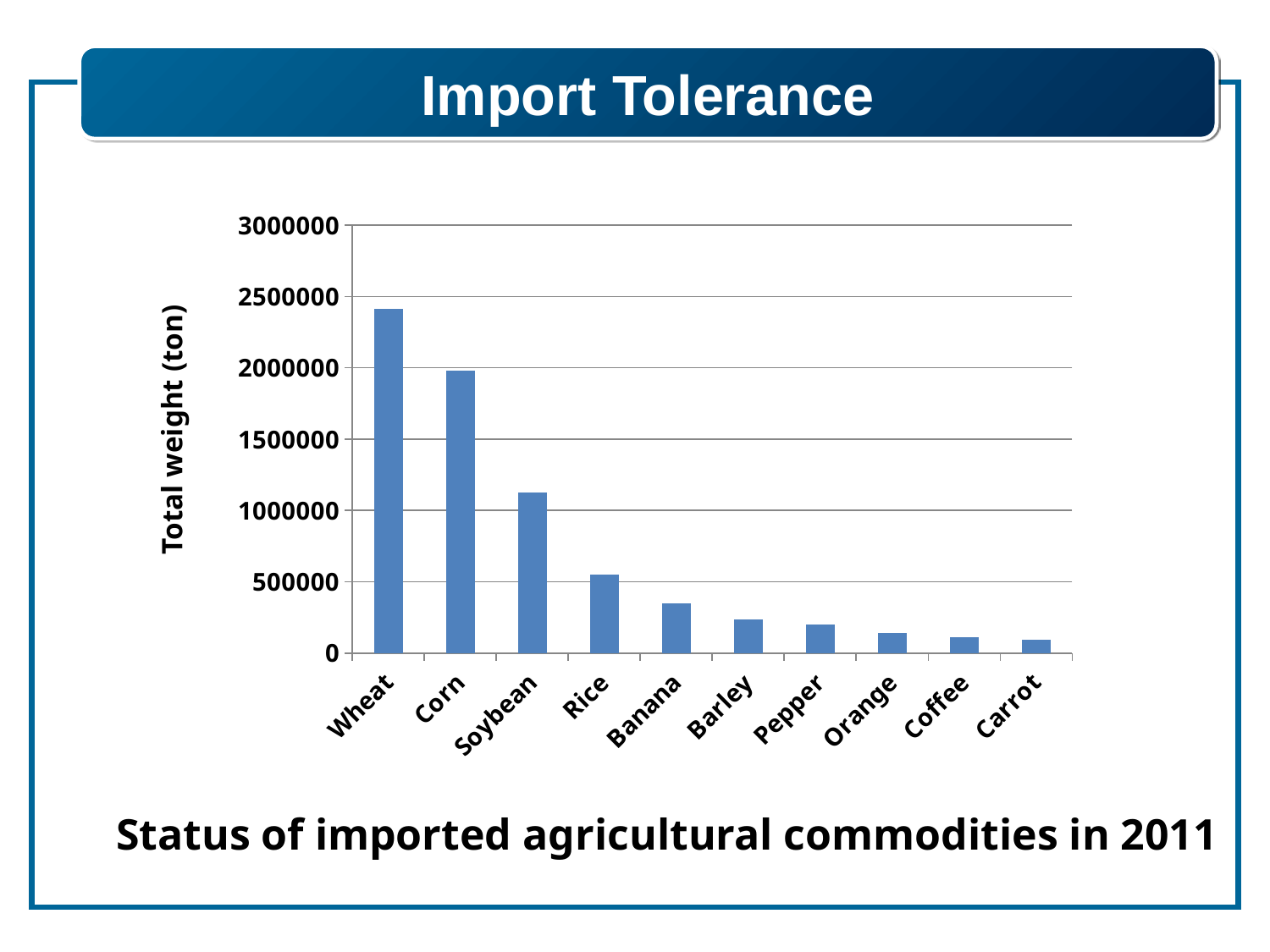
Which commodity has the lowest total weight? Carrot Is the total weight for Soybean greater or less than 1000000 tons? greater What is the label of the vertical axis? Total weight (ton) Is the total weight for Banana greater or less than 500000 tons? less Which has a larger total weight, Barley or Orange? Barley Which commodity has the highest total weight? Wheat How many commodities are shown on the chart? 10 Which has a larger total weight, Corn or Soybean? Corn Is the total weight for Rice greater or less than 1000000 tons? less What kind of chart is shown on the slide? Bar chart